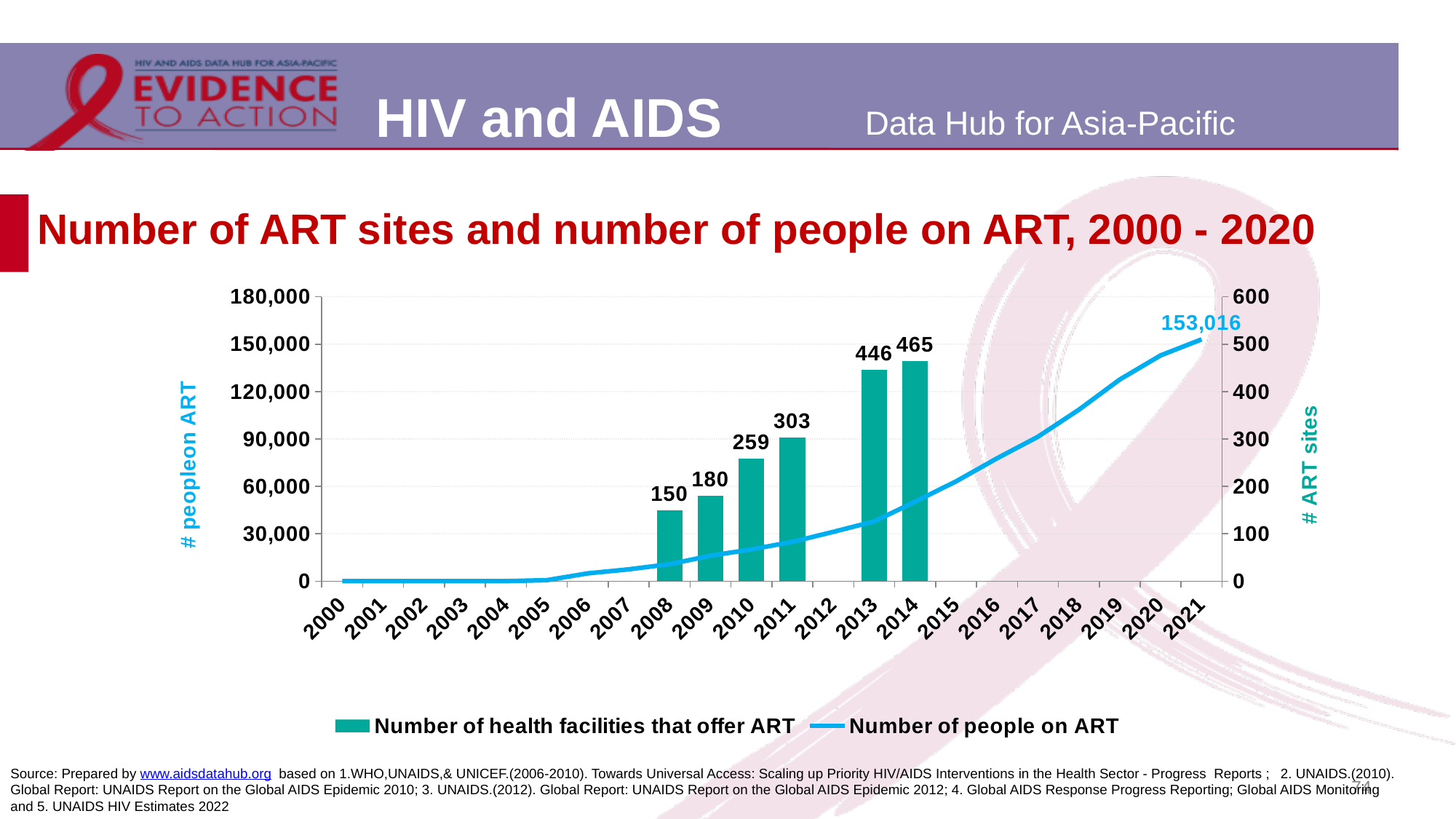
How many series does the legend list? 2 Which year has more health facilities that offer ART, 2009 or 2011? 2011 What is the difference in the number of health facilities that offer ART between 2014 and 2013? 19 Does the number of people on ART rise or fall from 2000 to 2021? rise Which year has the lowest labelled number of health facilities that offer ART? 2008 What is the label of the right-hand vertical axis? # ART sites What is the difference in the number of health facilities that offer ART between 2011 and 2010? 44 Is the number of people on ART in 2017 greater or less than 120,000? less Which year has the highest number of health facilities that offer ART? 2014 What is the number of health facilities that offer ART in 2008? 150 What is the number of health facilities that offer ART in 2014? 465 What is the number of people on ART in 2021? 153,016